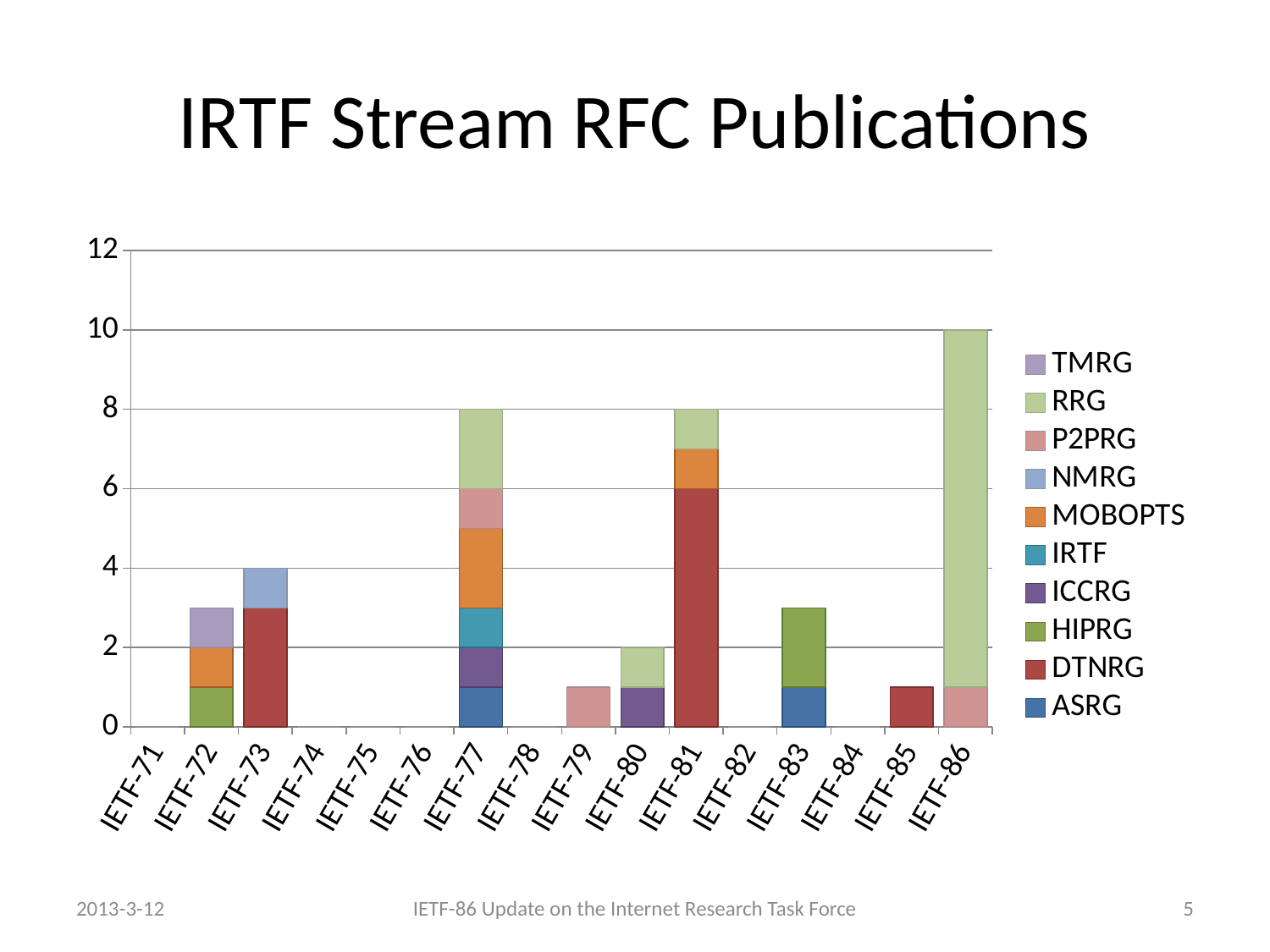
What is the total height of the stacked bar for IETF-86? 10 What is the title of the chart? IRTF Stream RFC Publications Is the total for IETF-85 greater or less than 2? less How many series does the legend list? 10 How many IETF meetings are shown along the x axis? 16 How many IETF meetings on the x axis have no bar at all? 7 Which IETF meeting has the highest total number of RFC publications? IETF-86 Is the total for IETF-72 greater or less than 2? greater What kind of chart is shown on the slide? Stacked bar chart Which has a larger total, IETF-86 or IETF-81? IETF-86 What is the total height of the stacked bar for IETF-73? 4 What is the total height of the stacked bar for IETF-77? 8